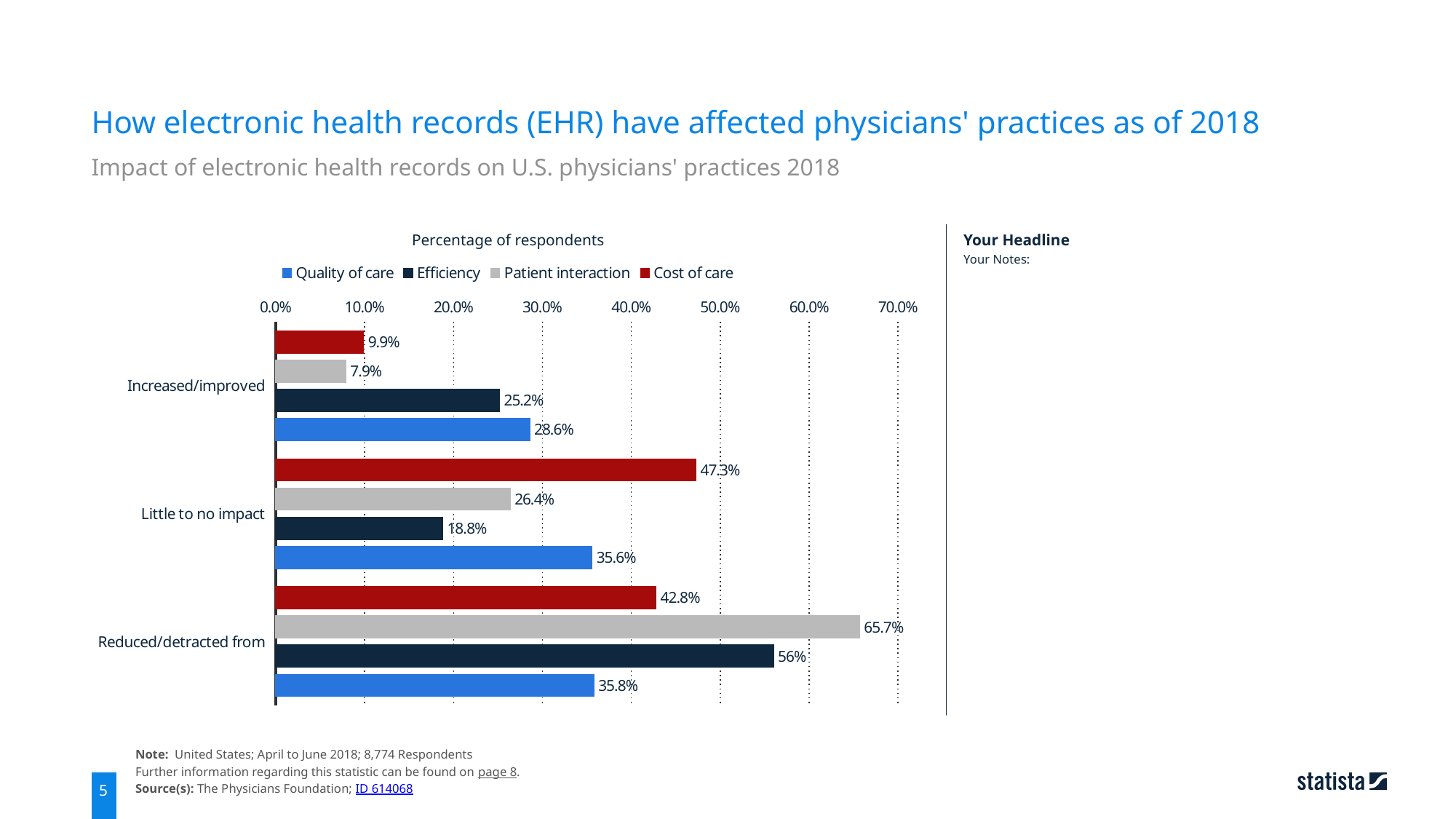
Which series has the lowest value in the Increased/improved category? Patient interaction Is the value for Efficiency in the Reduced/detracted from category greater or less than 50.0%? greater What is the difference between Quality of care and Efficiency in the Increased/improved category? 3.4% What is the value for Cost of care in the Little to no impact category? 47.3% What colour represents the Cost of care series in the chart? Red What percentage of respondents said EHR reduced/detracted from patient interaction? 65.7% What is the value for Efficiency in the Increased/improved category? 25.2% Which is larger in the Little to no impact category: Quality of care or Patient interaction? Quality of care How many series does the legend list? 4 What kind of chart is shown on the slide? Bar chart How many categories are shown on the vertical axis of the chart? 3 Which series has the highest value in the Reduced/detracted from category? Patient interaction